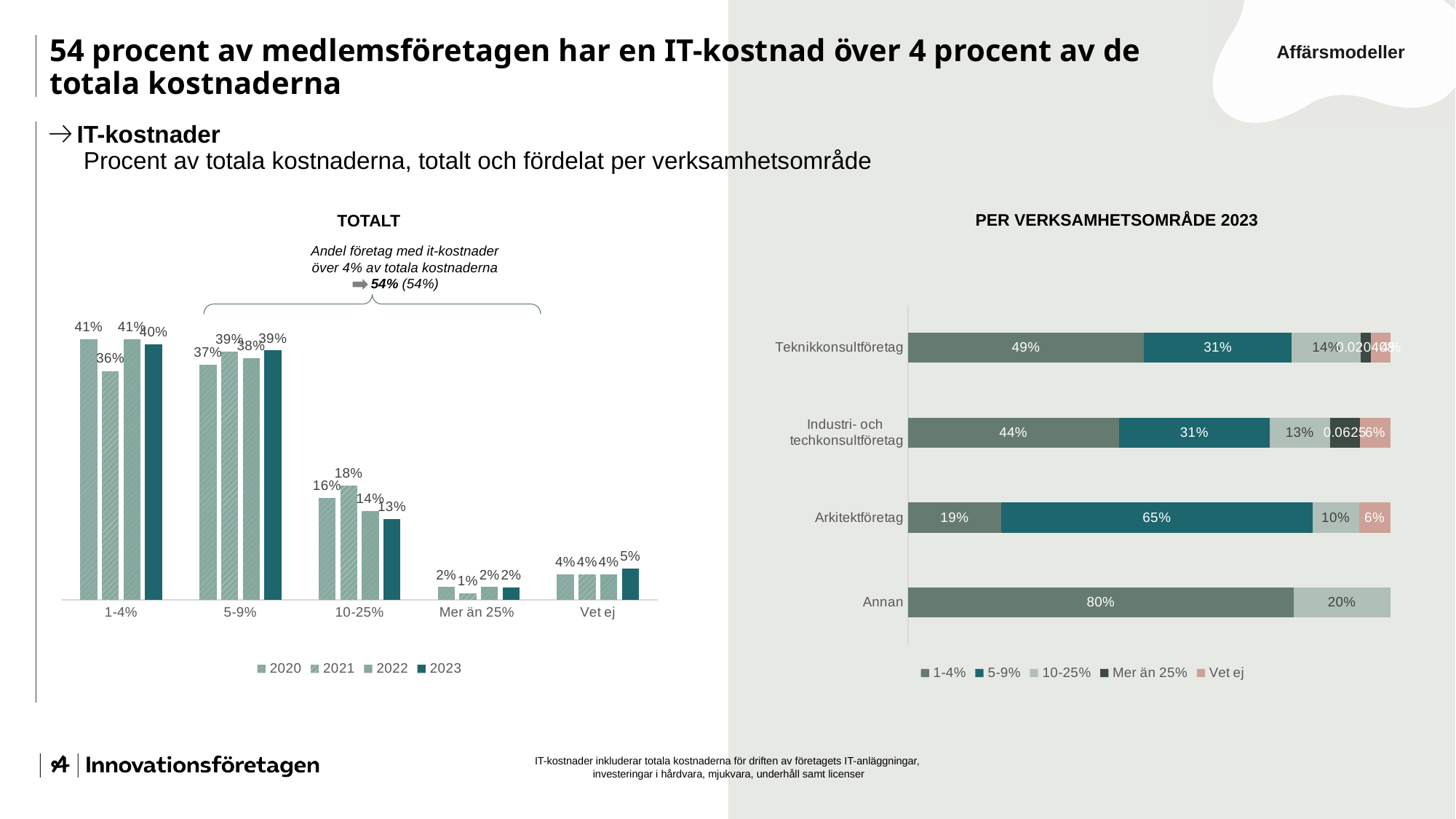
In the TOTALT chart, what is the value for 2021 in the 1-4% category? 36% In the TOTALT chart, what is the value for 2023 in the Vet ej category? 5% In the TOTALT chart, how many categories are shown on the x axis? 5 In the PER VERKSAMHETSOMRÅDE 2023 chart, which category has the highest 1-4% share? Annan In the PER VERKSAMHETSOMRÅDE 2023 chart, what is the 5-9% share for Arkitektföretag? 65% In the TOTALT chart, how many series does the legend list? 4 What kind of chart is the PER VERKSAMHETSOMRÅDE 2023 chart? Stacked horizontal bar chart In the PER VERKSAMHETSOMRÅDE 2023 chart, what is the 1-4% share for Annan? 80% In the TOTALT chart, which category has the lowest value for 2021? Mer än 25% In the TOTALT chart, what is the difference between the 2021 and 2023 values in the 10-25% category? 5% In the PER VERKSAMHETSOMRÅDE 2023 chart, is the 1-4% share larger for Teknikkonsultföretag or for Industri- och techkonsultföretag? Teknikkonsultföretag In the TOTALT chart, what is the value for 2023 in the 10-25% category? 13%